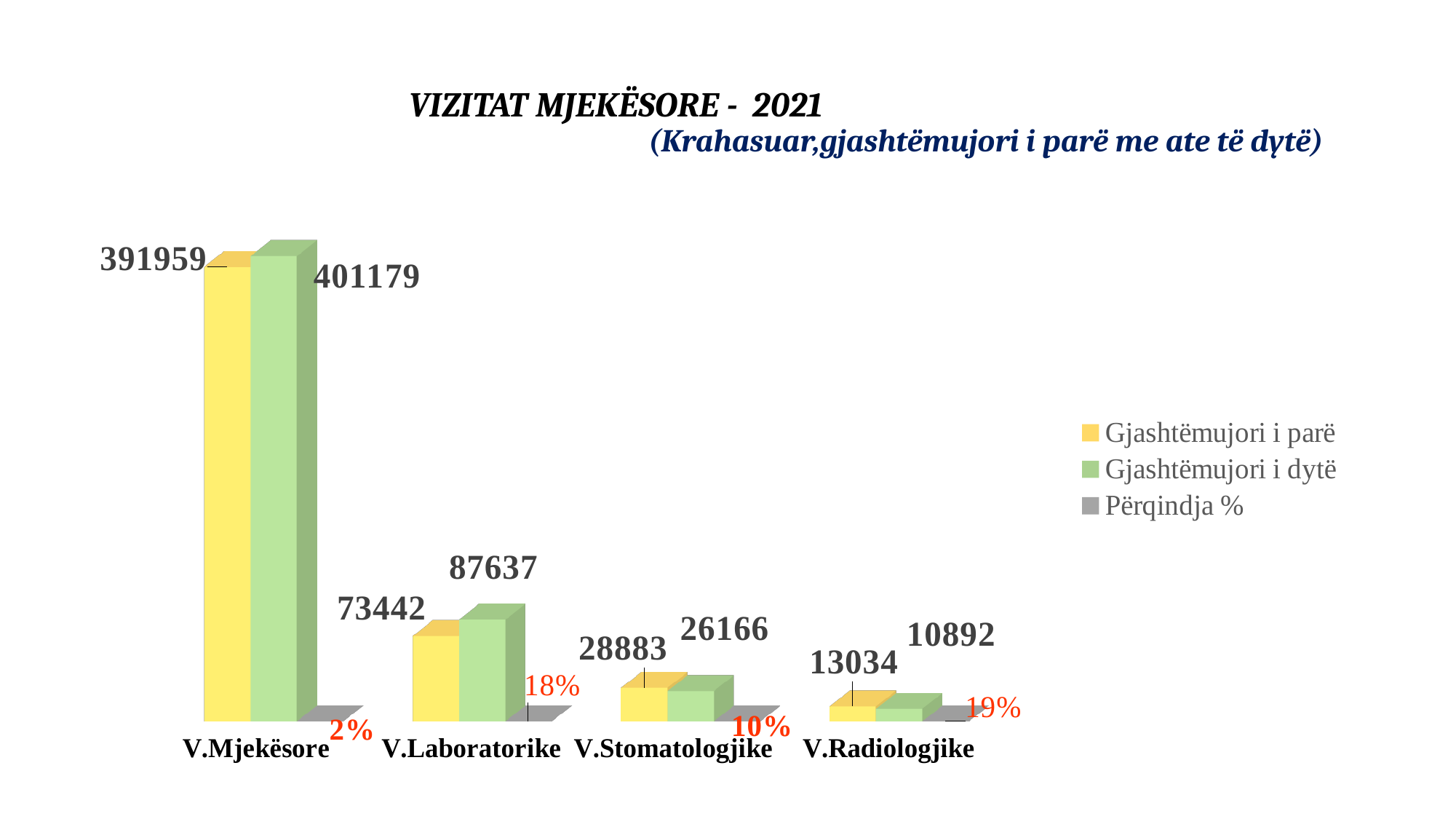
How many series does the legend list? 3 What is the value for V.Laboratorike in the Gjashtëmujori i dytë series? 87637 How many categories are shown on the x axis? 4 What is the difference between the Gjashtëmujori i parë and Gjashtëmujori i dytë values for V.Radiologjike? 2142 What kind of chart is shown on the slide? Bar chart What is the difference between the Gjashtëmujori i dytë and Gjashtëmujori i parë values for V.Laboratorike? 14195 What is the value for V.Stomatologjike in the Gjashtëmujori i dytë series? 26166 For V.Stomatologjike, which is larger: the Gjashtëmujori i parë value or the Gjashtëmujori i dytë value? Gjashtëmujori i parë Which category has the highest value in the Gjashtëmujori i dytë series? V.Mjekësore Which category has the lowest value in the Gjashtëmujori i parë series? V.Radiologjike What is the value for V.Mjekësore in the Gjashtëmujori i parë series? 391959 What is the Përqindja % value for V.Radiologjike? 19%